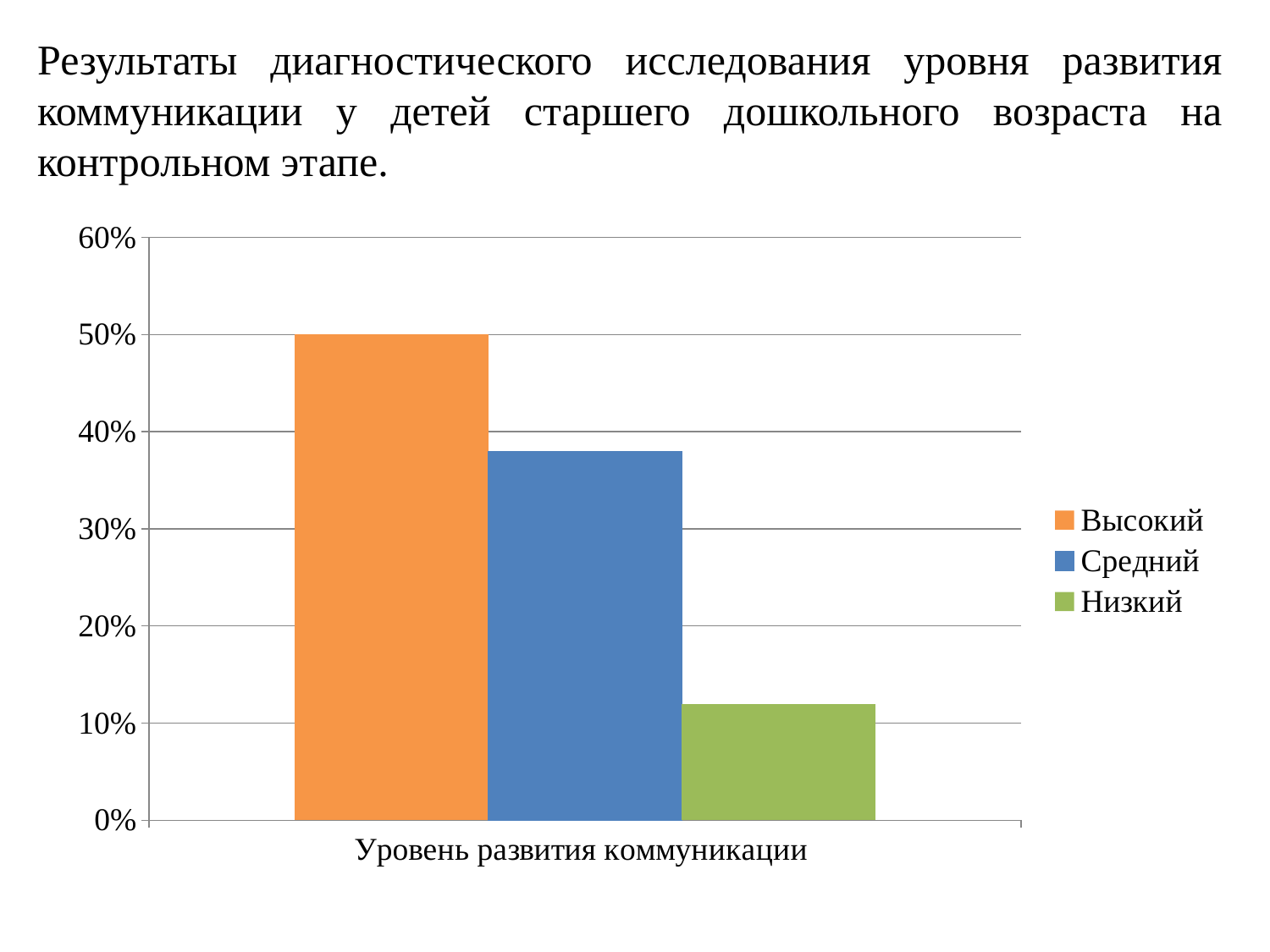
How many series does the legend list? 3 Which is larger, the value for Средний or the value for Низкий? Средний What is the value for Высокий? 50% What colour is the bar for Низкий? green Is the value for Средний greater or less than 30%? greater Is the value for Средний greater or less than 40%? less Is the value for Низкий greater or less than 10%? greater What is the category label shown on the x axis? Уровень развития коммуникации Which series has the highest value? Высокий Which series has the lowest value? Низкий What kind of chart is shown on the slide? bar chart